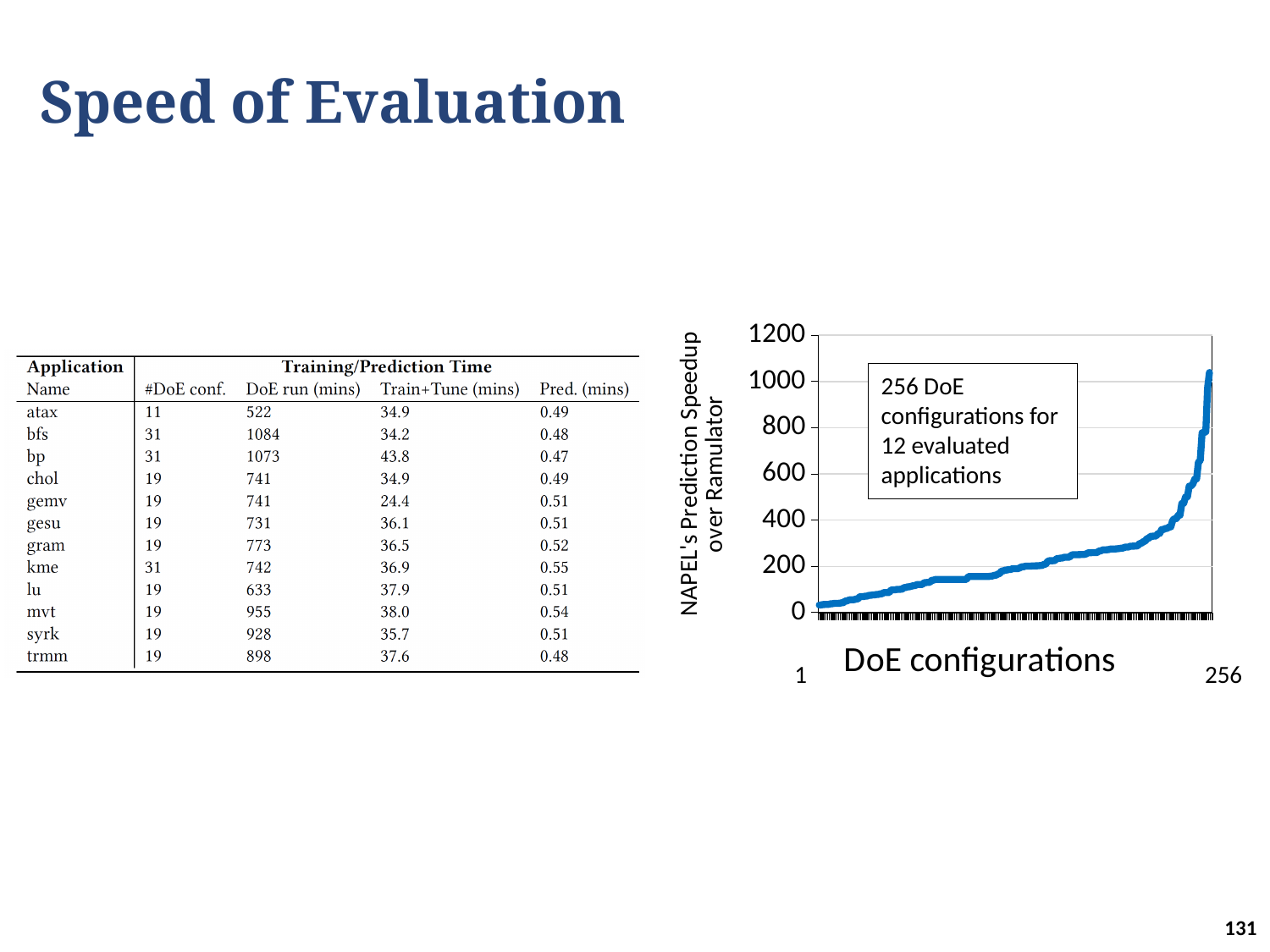
What is the label of the x axis in the chart on the right? DoE configurations In the chart on the right, is the speedup value at the midpoint of the x axis (around configuration 128) greater or less than 400? less In the chart on the right, is the highest plotted speedup value greater or less than 800? greater What kind of chart is shown on the right side of the slide? line chart How many DoE configurations are plotted in the chart on the right? 256 In the chart on the right, which end of the x axis has the larger speedup value, configuration 1 or configuration 256? 256 In the chart on the right, is the speedup value for the first DoE configuration greater or less than 200? less In the chart on the right, do the values rise or fall as you move along the x axis from configuration 1 to 256? rise What is the highest tick value shown on the y axis of the chart on the right? 1200 What is the label of the y axis in the chart on the right? NAPEL's Prediction Speedup over Ramulator